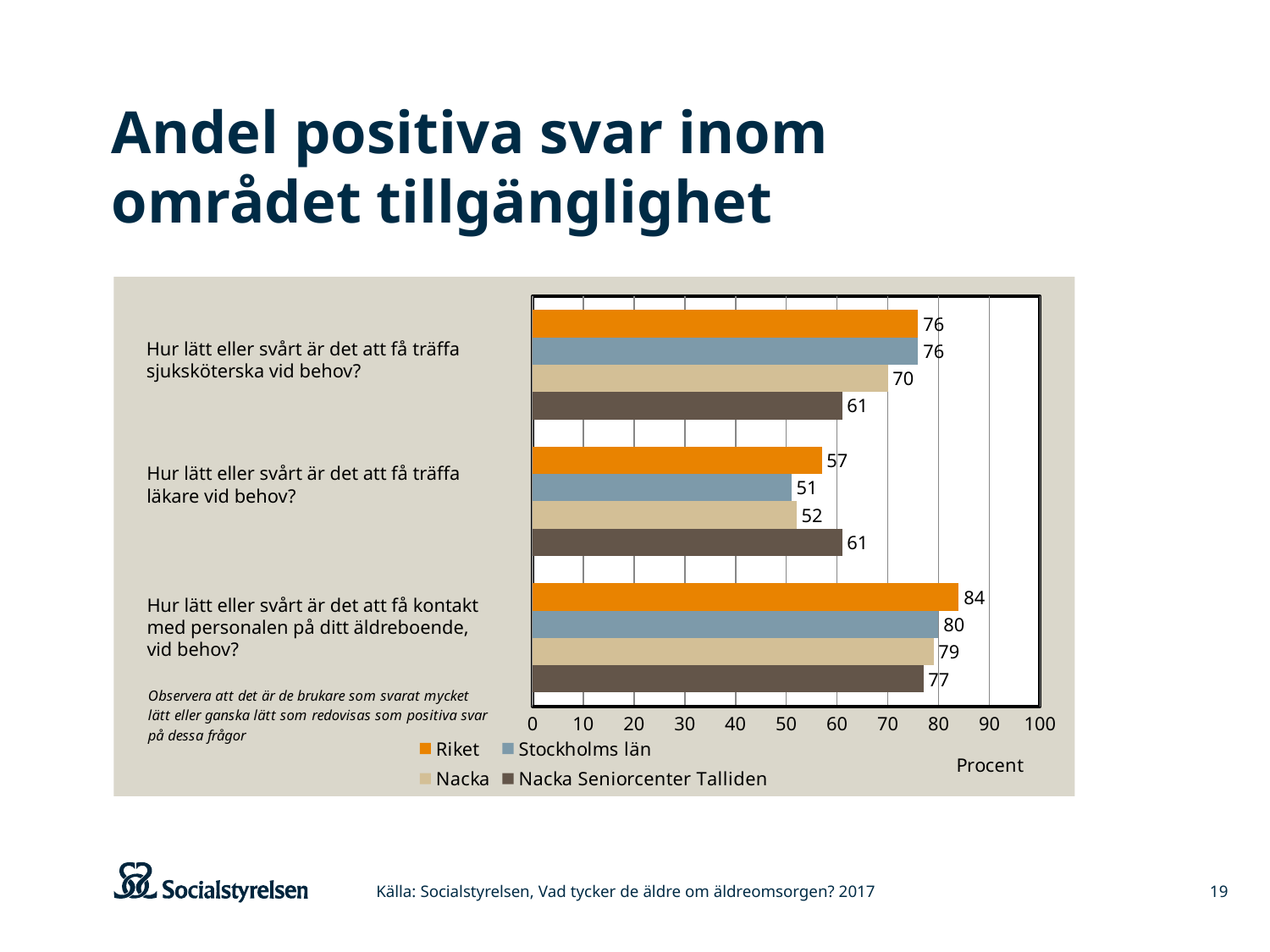
How many series does the legend list? 4 What kind of chart is shown on the slide? Bar chart How many question categories are plotted on the chart? 3 What label is shown on the horizontal axis of the chart? Procent What is the difference between the Riket value and the Nacka Seniorcenter Talliden value for "Hur lätt eller svårt är det att få träffa sjuksköterska vid behov?"? 15 Is the Nacka value for "Hur lätt eller svårt är det att få träffa sjuksköterska vid behov?" greater or less than 60? greater What is the value for Stockholms län for "Hur lätt eller svårt är det att få kontakt med personalen på ditt äldreboende, vid behov?"? 80 For "Hur lätt eller svårt är det att få träffa läkare vid behov?", which is larger: the value for Riket or the value for Nacka Seniorcenter Talliden? Nacka Seniorcenter Talliden Which series has the lowest value for "Hur lätt eller svårt är det att få träffa läkare vid behov?"? Stockholms län What is the value for Nacka Seniorcenter Talliden for "Hur lätt eller svårt är det att få träffa läkare vid behov?"? 61 What is the value for Riket for "Hur lätt eller svårt är det att få träffa sjuksköterska vid behov?"? 76 Which series has the highest value for "Hur lätt eller svårt är det att få kontakt med personalen på ditt äldreboende, vid behov?"? Riket